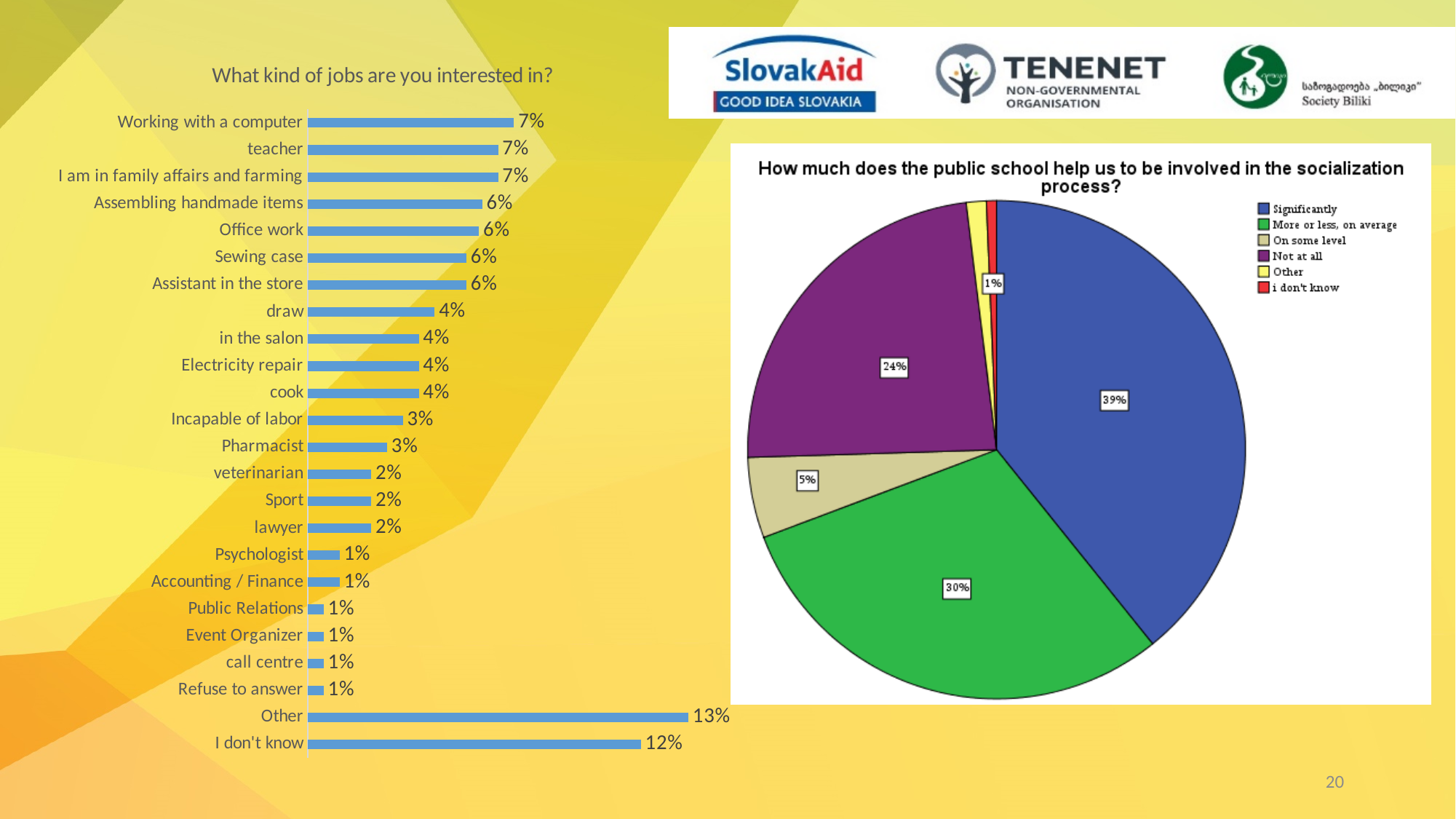
What kind of chart is the chart titled "What kind of jobs are you interested in?"? bar chart In the pie chart on the right, how many entries does the legend list? 6 In the pie chart on the right, what is the value for Not at all? 24% In the chart titled "What kind of jobs are you interested in?", which category has the highest value? Other In the chart titled "What kind of jobs are you interested in?", what is the value for Office work? 6% In the pie chart on the right, what share of the pie is labelled Significantly? 39% In the chart titled "What kind of jobs are you interested in?", what is the difference between the values for Other and I don't know? 1% In the chart titled "What kind of jobs are you interested in?", how many categories are shown? 24 In the pie chart on the right, what is the difference between the values for Significantly and More or less, on average? 9% In the chart titled "What kind of jobs are you interested in?", which is larger, the value for teacher or the value for cook? teacher In the pie chart on the right, which category has the largest slice? Significantly In the chart titled "What kind of jobs are you interested in?", what is the value for Pharmacist? 3%